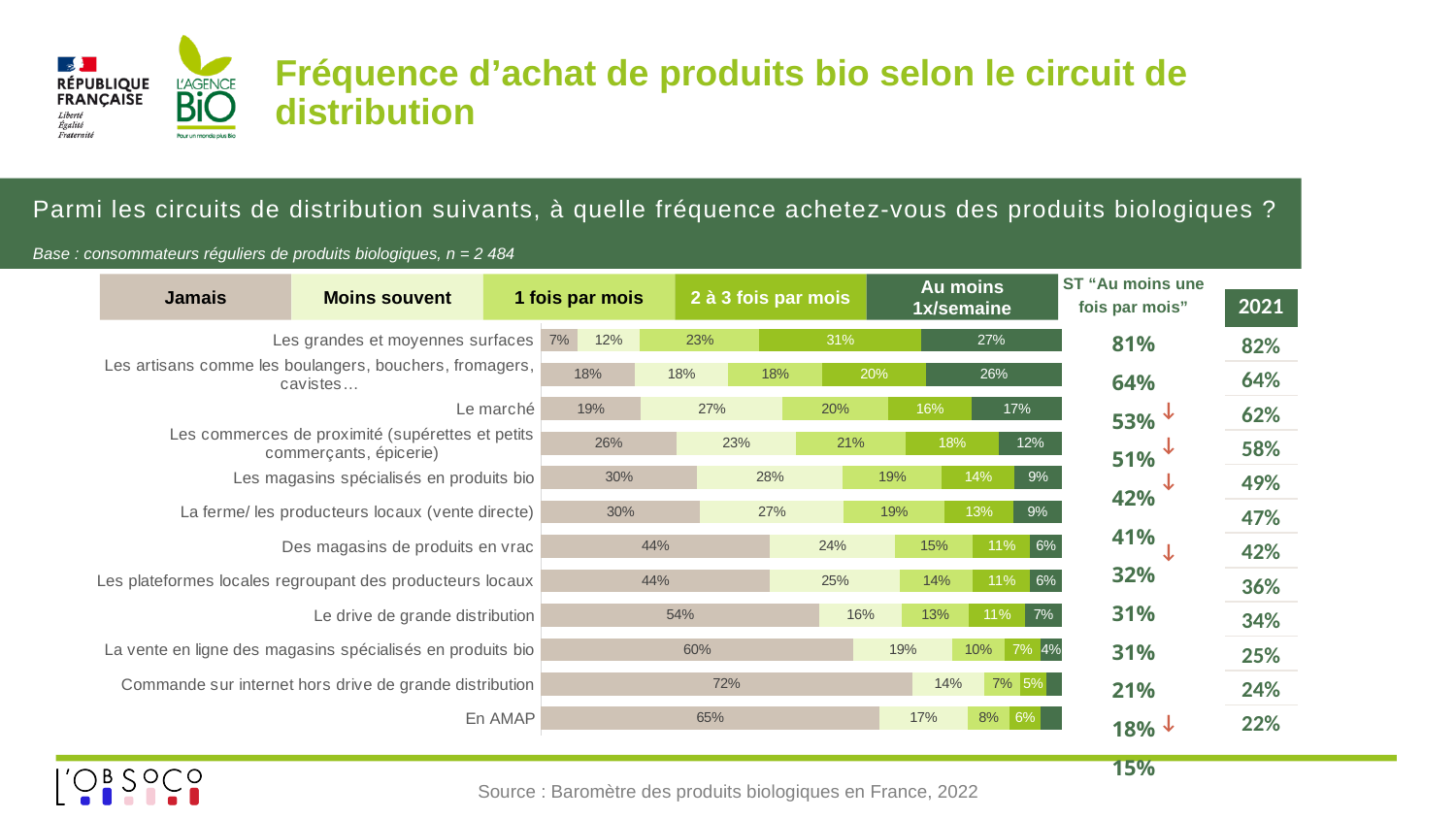
What is the 'Jamais' value for 'Les grandes et moyennes surfaces'? 7% Which distribution channel has the lowest 'Jamais' value? Les grandes et moyennes surfaces What is the 'ST "Au moins une fois par mois"' value shown for 'Les magasins spécialisés en produits bio'? 42% How many series does the legend list? 5 What is the 'Moins souvent' value for 'Le marché'? 27% What is the 'Au moins 1x/semaine' value for 'Les artisans comme les boulangers, bouchers, fromagers, cavistes…'? 26% How many distribution channels (categories) are plotted in the chart? 12 What is the total of the stacked bar for 'Les grandes et moyennes surfaces'? 100% What kind of chart is shown on the slide? Stacked bar chart Which has a larger '2 à 3 fois par mois' value: 'Les grandes et moyennes surfaces' or 'Le marché'? Les grandes et moyennes surfaces Which distribution channel has the highest 'Jamais' value? Commande sur internet hors drive de grande distribution What is the difference between the 'Jamais' values for 'En AMAP' and 'Le drive de grande distribution'? 11%